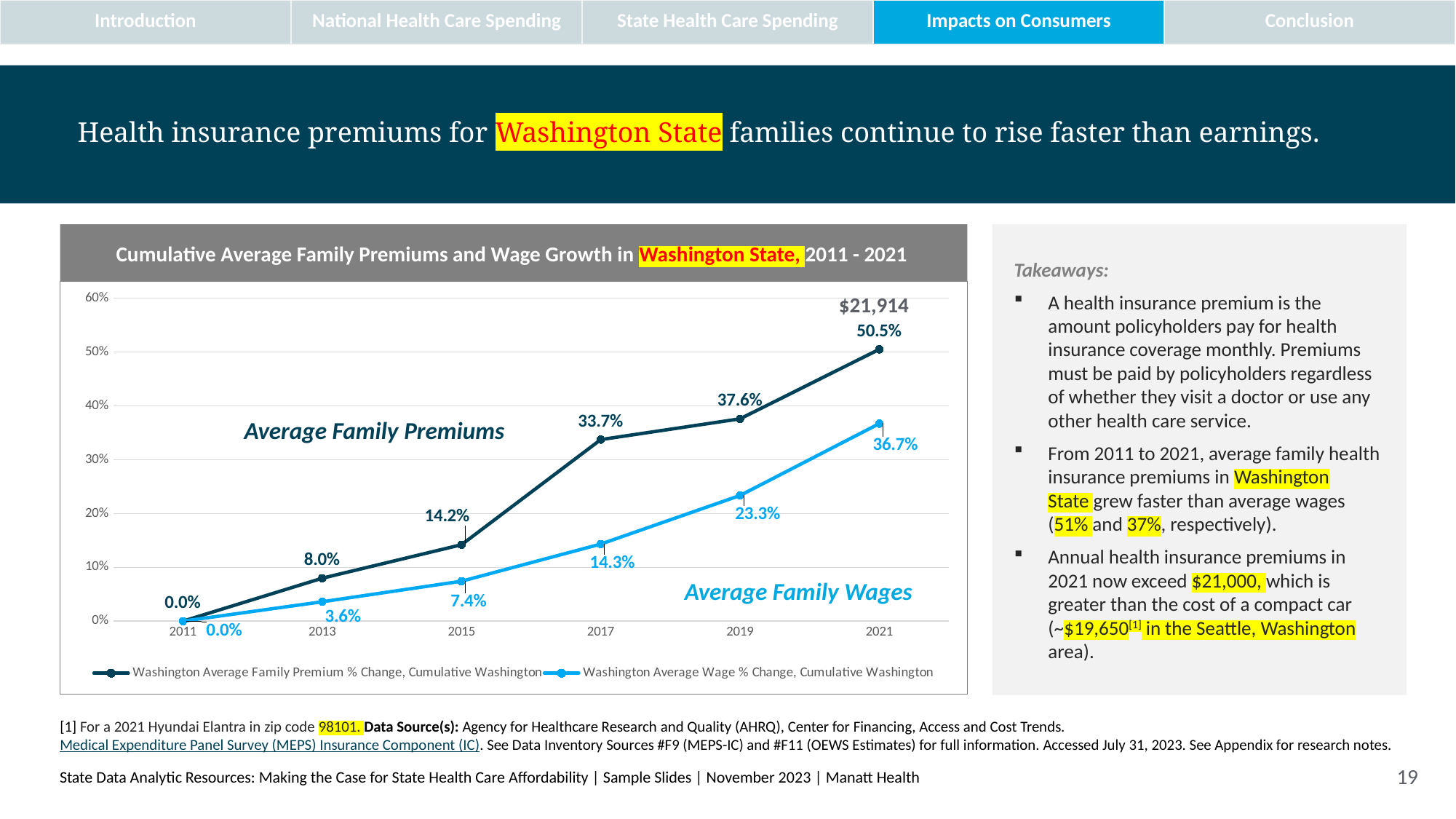
What is the cumulative average wage % change in Washington State in 2019? 23.3% What is the difference between the premium % change in 2017 and the wage % change in 2017? 19.4% What is the cumulative average wage % change in 2013? 3.6% In which year does the cumulative average family premium % change reach its highest value? 2021 What is the difference between the premium % change and the wage % change in 2021? 13.8% What kind of chart is shown on the slide? Line chart How many series does the legend list? 2 Does the cumulative average wage % change rise or fall from 2011 to 2021? Rise What is the cumulative average family premium % change in Washington State in 2021? 50.5% How many years are plotted on the x axis? 6 In 2019, which is larger: the cumulative premium % change or the cumulative wage % change? Cumulative premium % change What is the cumulative average family premium % change in 2015? 14.2%